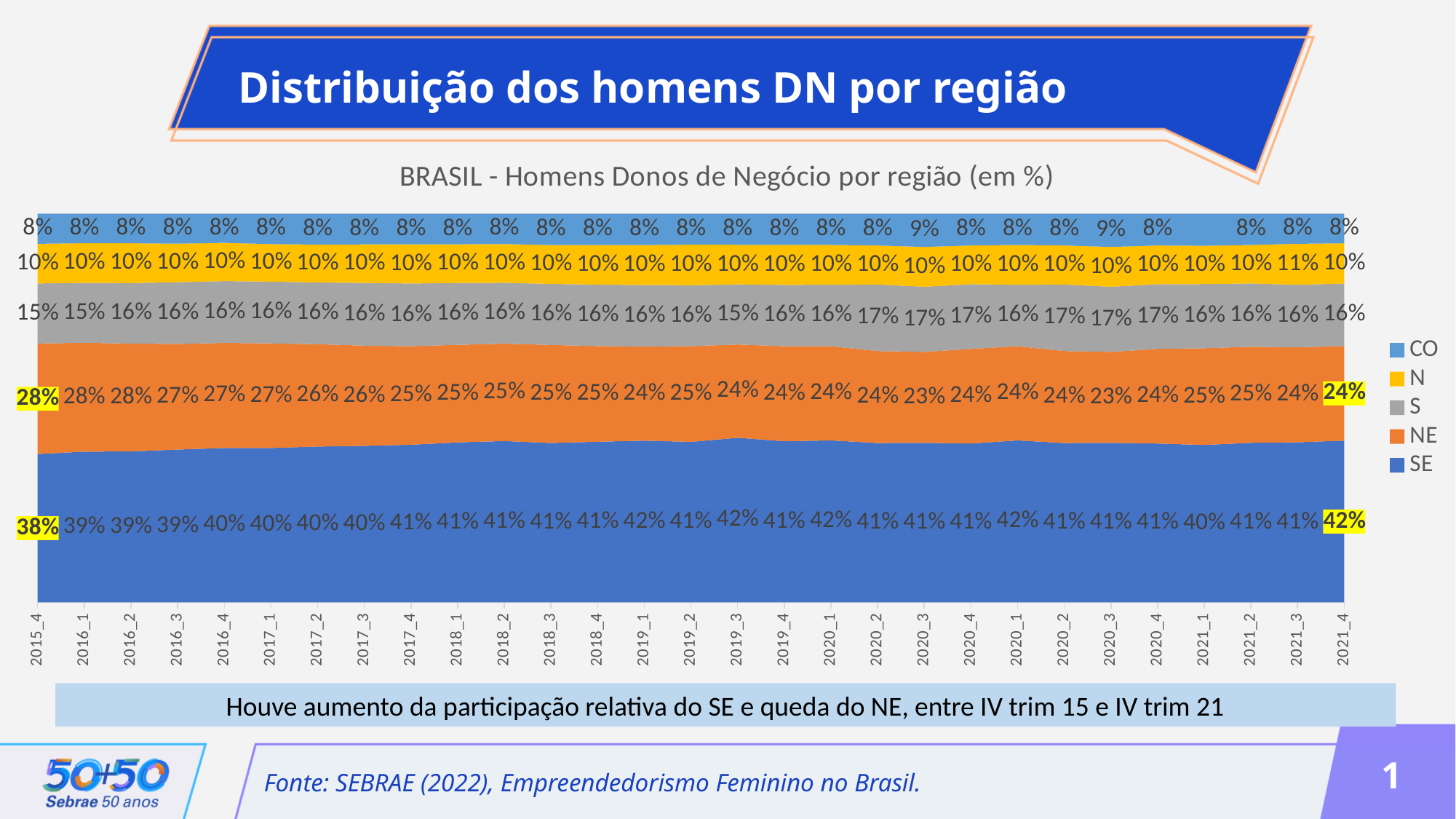
Which region has the largest share at 2021_4? SE What is the value for NE at 2015_4? 28% How many series does the legend list? 5 What is the value for SE at 2021_4? 42% Does the SE share rise or fall from 2015_4 to 2021_4? Rise Which region has the smallest share at 2021_4? CO What is the value for NE at 2021_4? 24% By how many percentage points did the SE share change between 2015_4 and 2021_4? 4 percentage points What is the title of the chart? BRASIL - Homens Donos de Negócio por região (em %) By how many percentage points did the NE share change between 2015_4 and 2021_4? 4 percentage points What is the value for SE at 2015_4? 38% What kind of chart is shown on the slide? Stacked area chart